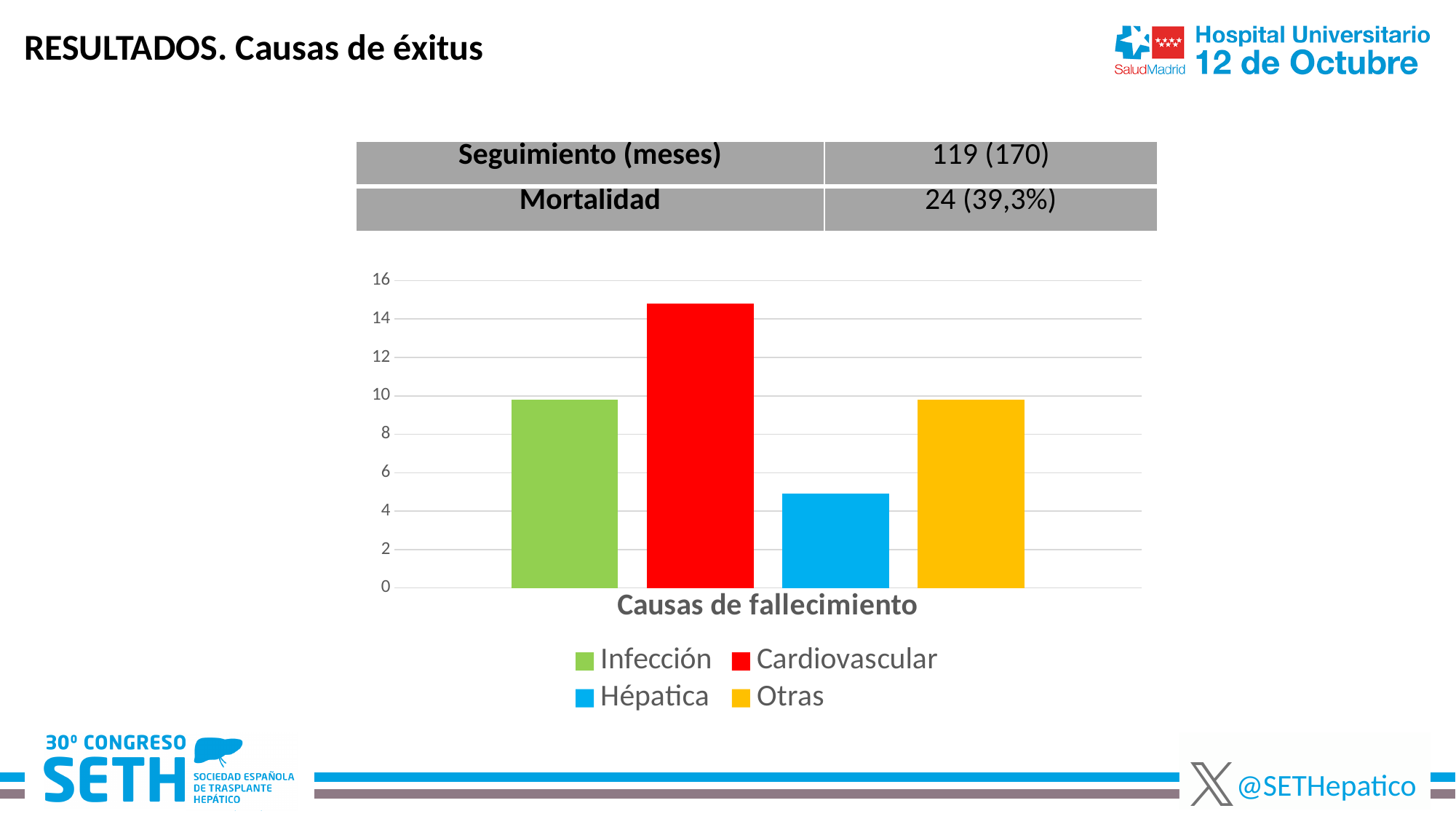
Is the value for Cardiovascular greater or less than 14? greater Which cause of death has the lowest bar in the chart? Hépatica Is the value for Infección greater or less than 8? greater How many series does the chart legend list? 4 Which is larger, the value for Hépatica or the value for Otras? Otras What colour is the Cardiovascular bar in the chart? red What is the title shown below the bars of the chart? Causas de fallecimiento What kind of chart is shown on the slide? bar chart Which cause of death has the highest bar in the chart? Cardiovascular Is the value for Hépatica greater or less than 6? less Which is larger, the value for Cardiovascular or the value for Infección? Cardiovascular